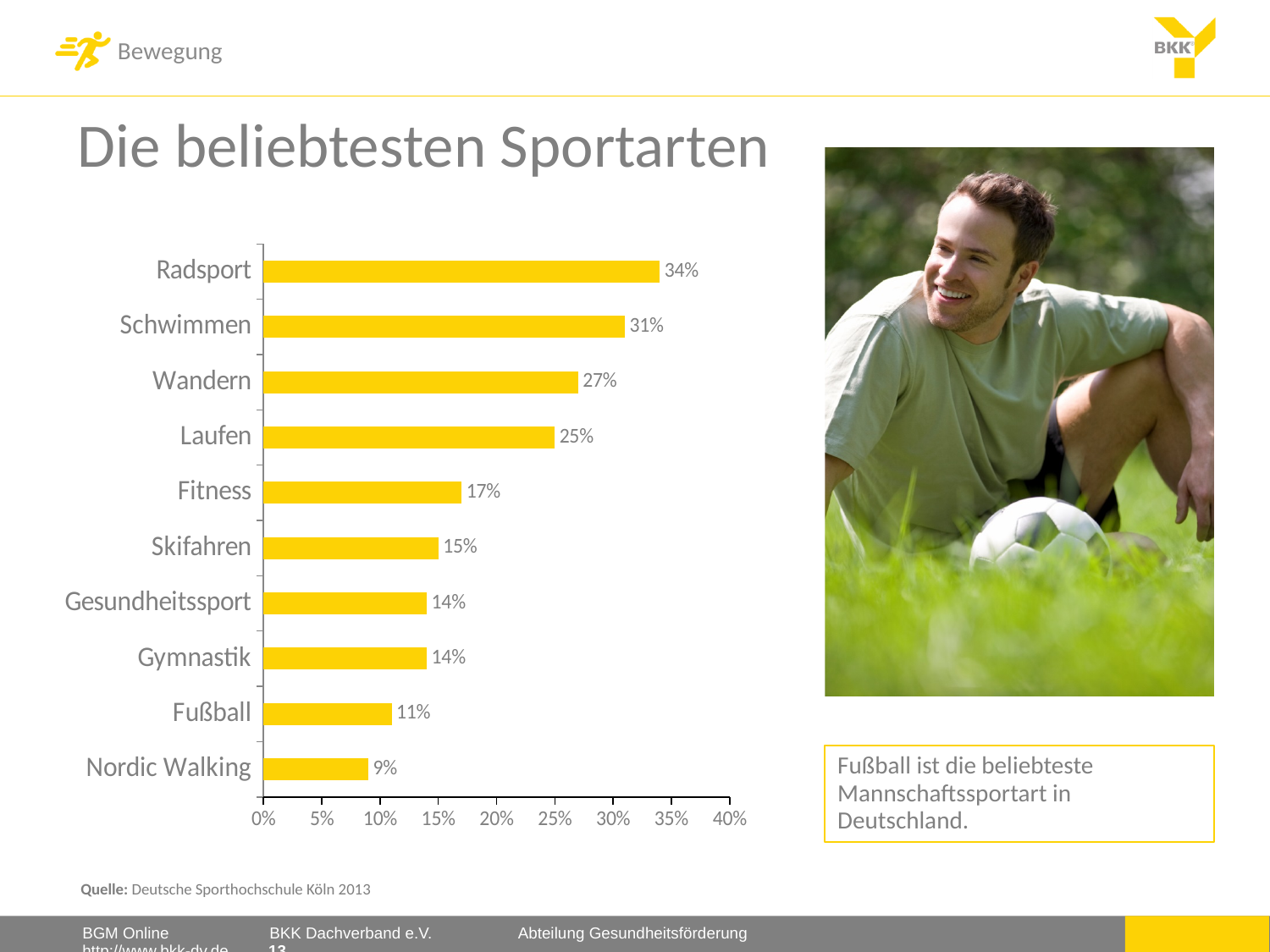
What is the value for Fußball? 11% What is the value for Radsport? 34% Which is larger, the value for Wandern or the value for Laufen? Wandern What is the difference between the values for Laufen and Fitness? 8% What is the value for Skifahren? 15% Which category has the lowest value? Nordic Walking What is the difference between the values for Radsport and Schwimmen? 3% How many categories are shown in the chart? 10 What kind of chart is shown on the slide? bar chart What is the value for Gymnastik? 14% What is the title of the chart? Die beliebtesten Sportarten Which category has the highest value? Radsport